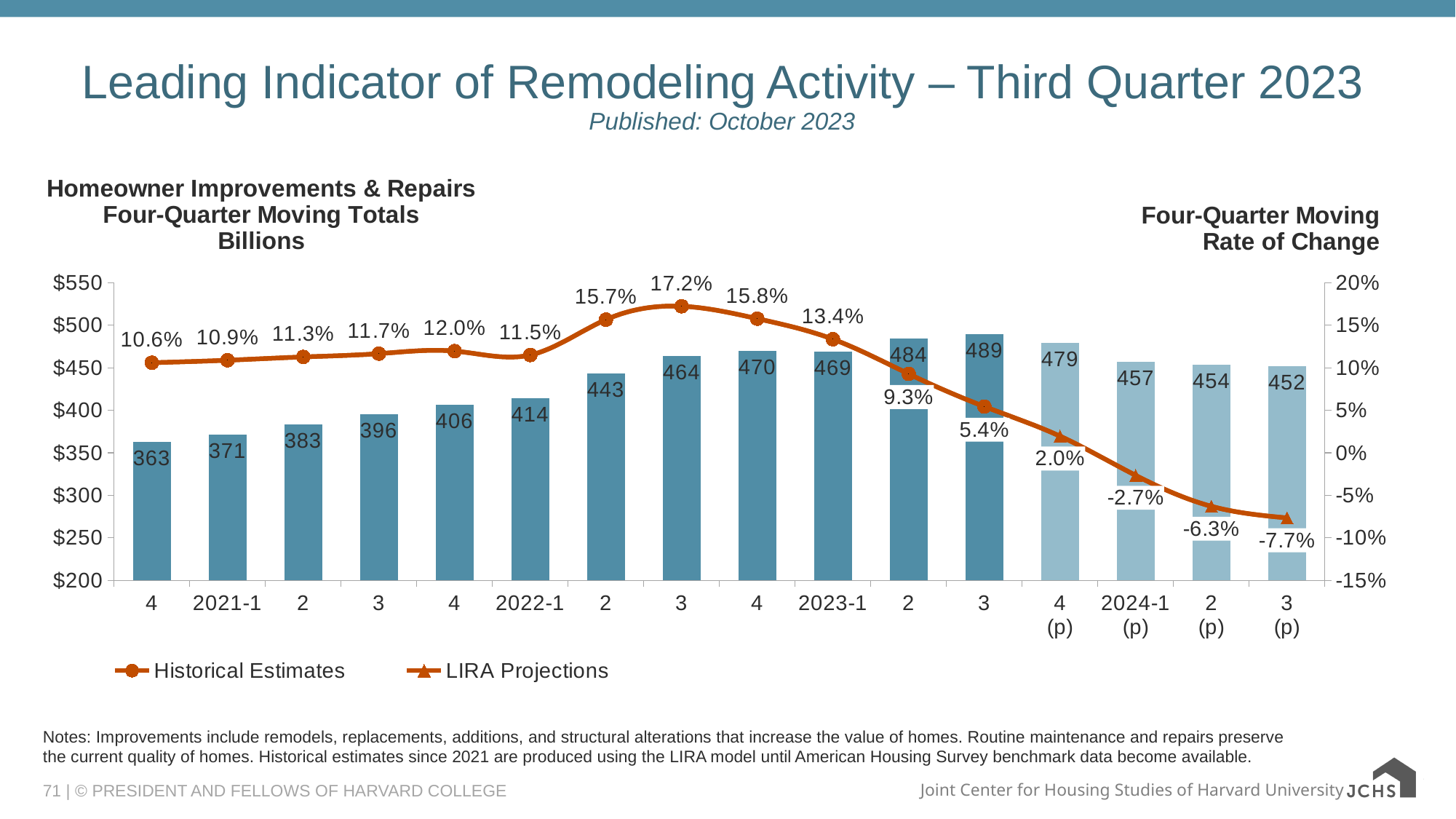
What is the difference between the highest bar (489) and the lowest bar (363)? 126 How many quarters (bars) are plotted on the chart? 16 What is the four-quarter moving total (in billions) shown for 2023-1? 469 Which quarter has the lowest four-quarter moving rate of change? 2024 quarter 3 (p), at -7.7% What four-quarter moving rate of change is shown for the third quarter of 2022? 17.2% After peaking in the third quarter of 2022, does the four-quarter moving rate of change rise or fall through 2024-3 (p)? It falls By how many percentage points does the peak rate of change (17.2%) exceed the first value shown (10.6%)? 6.6 percentage points Which quarter has the highest four-quarter moving total bar? 2023 quarter 3 (489) What is the projected rate of change for 2024-1 (p)? -2.7% Which is larger, the four-quarter moving total for 2022-2 or for 2024-1 (p)? 2024-1 (p), 457 vs 443 How many series does the legend list? 2 What kind of chart is this? A combination bar and line chart